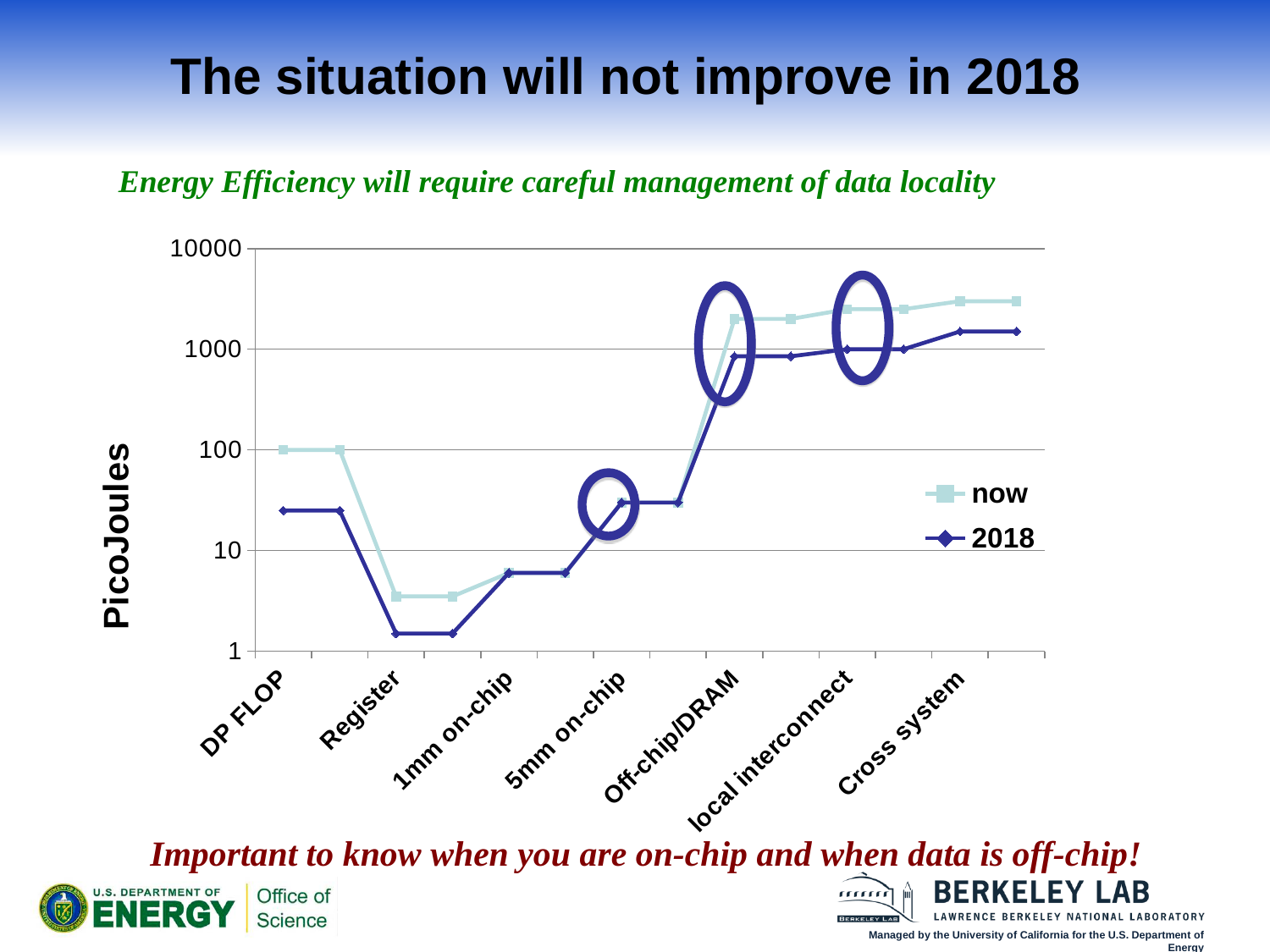
What is the label on the vertical axis? PicoJoules Does the 2018 series rise or fall from 5mm on-chip to Off-chip/DRAM? rise What kind of chart is shown on the slide? line chart For the 'now' series, which category has the lowest value? Register At DP FLOP, which series has the higher value, now or 2018? now Is the 'now' value for Register greater or less than 10? less Is the 'now' value for Cross system greater or less than 1000? greater How many categories are labelled along the x axis? 7 How many series does the legend list? 2 Is the 2018 value for Off-chip/DRAM greater or less than 100? greater For the 2018 series, which category has the highest value? Cross system What are the two series named in the legend? now and 2018